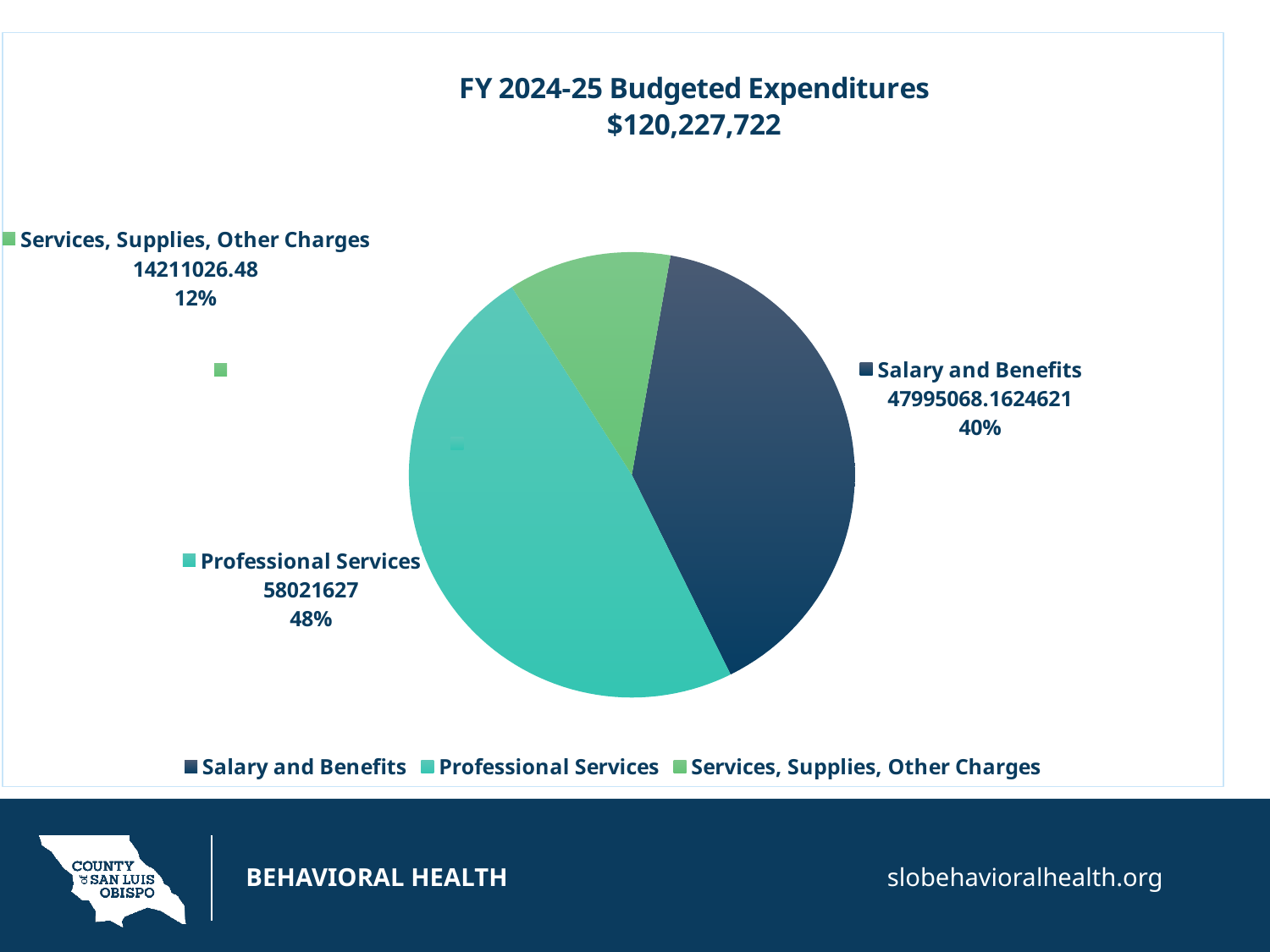
What kind of chart is shown on the slide? Pie chart What is the value shown for Professional Services? 58021627 Which category has the largest share of the pie? Professional Services What percentage share does Salary and Benefits have? 40% What is the title of the chart? FY 2024-25 Budgeted Expenditures $120,227,722 What is the value shown for Services, Supplies, Other Charges? 14211026.48 Which category has the smallest share of the pie? Services, Supplies, Other Charges What percentage share does Services, Supplies, Other Charges have? 12% Which is larger, the share for Salary and Benefits or the share for Services, Supplies, Other Charges? Salary and Benefits How many entries does the legend list? 3 What percentage share does Professional Services have? 48% How many slices does the pie chart have? 3